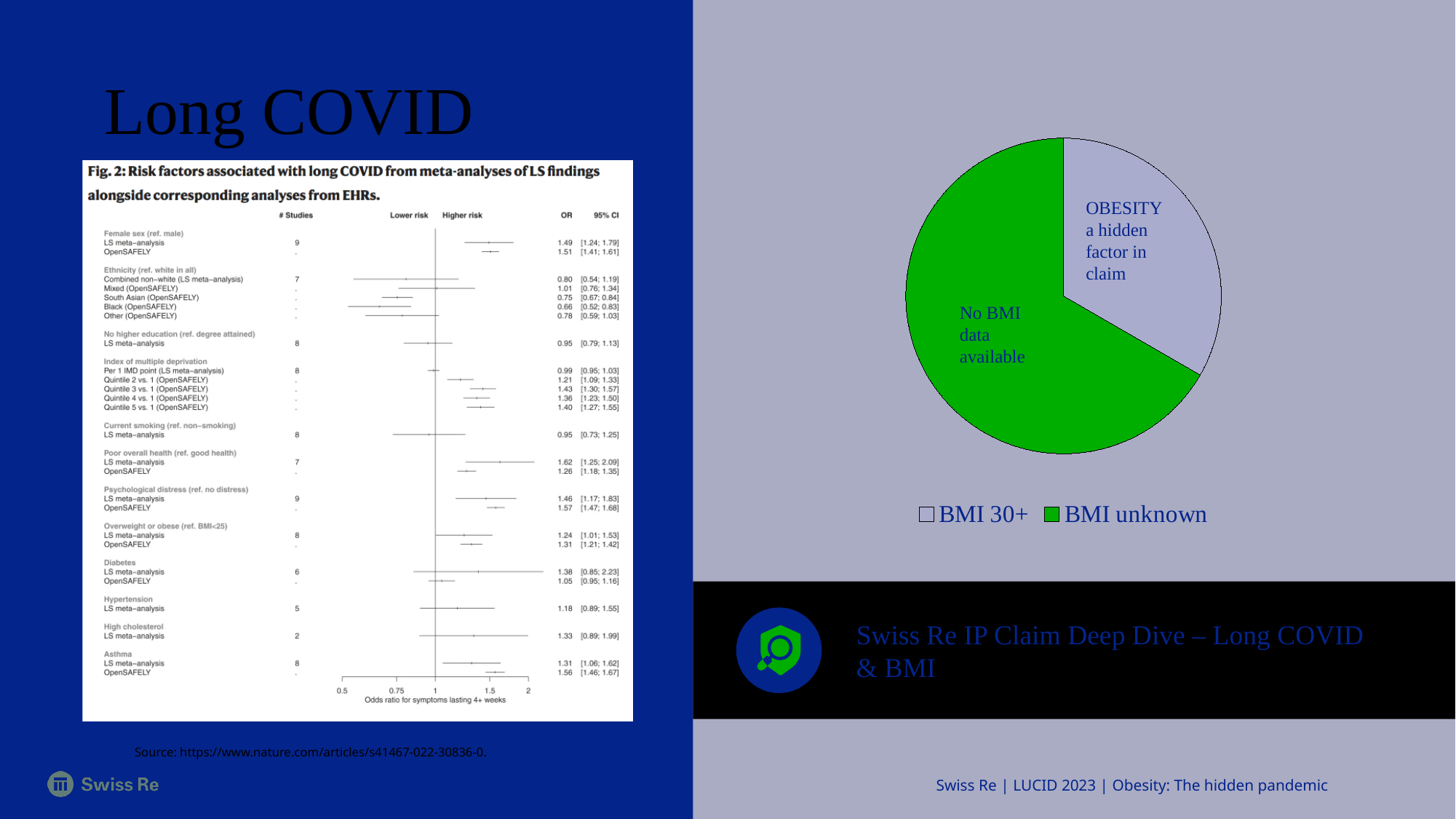
In the pie chart on the right, which slice is the smallest? BMI 30+ In the pie chart on the right, which slice is larger, BMI 30+ or BMI unknown? BMI unknown In the pie chart on the right, what text label is written inside the BMI 30+ slice? OBESITY a hidden factor in claim In the forest plot on the left (Fig. 2), which has the higher OR: Diabetes LS meta-analysis or Diabetes OpenSAFELY? Diabetes LS meta-analysis In the forest plot on the left (Fig. 2), what is the OR for Black (OpenSAFELY) under Ethnicity? 0.66 In the forest plot on the left (Fig. 2), how many studies are listed for the Female sex LS meta-analysis? 9 What kind of chart is shown on the right side of the slide? pie chart In the forest plot on the left (Fig. 2), what is the OR for Female sex, OpenSAFELY? 1.51 In the pie chart on the right, how many entries does the legend list? 2 In the pie chart on the right, what colour is the BMI unknown slice? green In the forest plot on the left (Fig. 2), what is the OR for Female sex, LS meta-analysis? 1.49 In the forest plot on the left (Fig. 2), what is the OR for Poor overall health, LS meta-analysis? 1.62